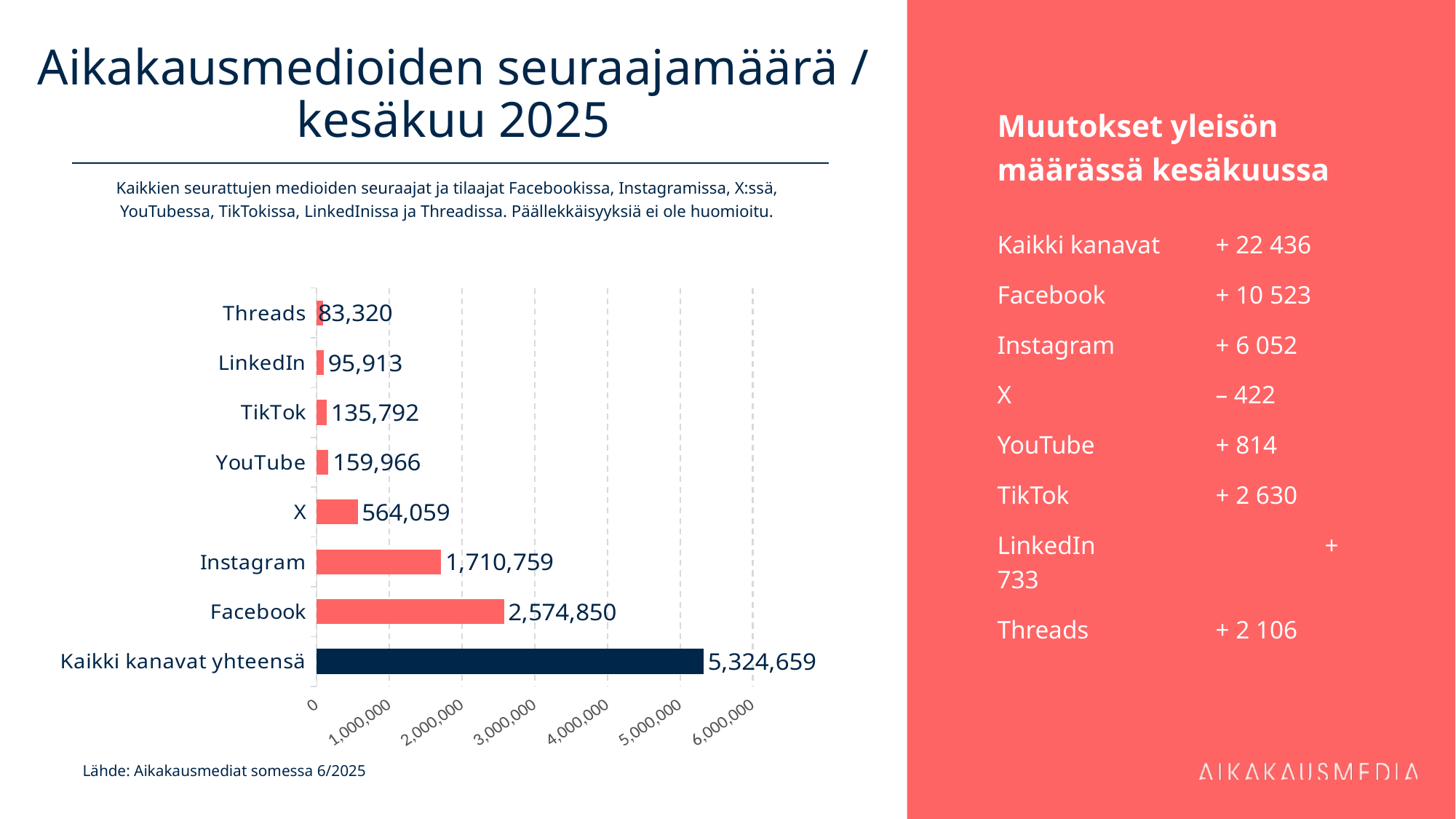
What is the difference between the YouTube and TikTok values? 24,174 What is the value for Facebook in the bar chart? 2,574,850 How many categories (bars) are shown in the chart? 8 What type of chart is shown on the slide? Bar chart Which category has the lowest value in the chart? Threads What is the value shown for Kaikki kanavat yhteensä? 5,324,659 Which is larger, the value for X or the value for YouTube? X What is the title of the slide containing the chart? Aikakausmedioiden seuraajamäärä / kesäkuu 2025 What is the value for Threads in the bar chart? 83,320 Which individual channel (excluding the total bar) has the highest value? Facebook What is the difference between the Facebook and Instagram values? 864,091 What is the value for Instagram in the bar chart? 1,710,759